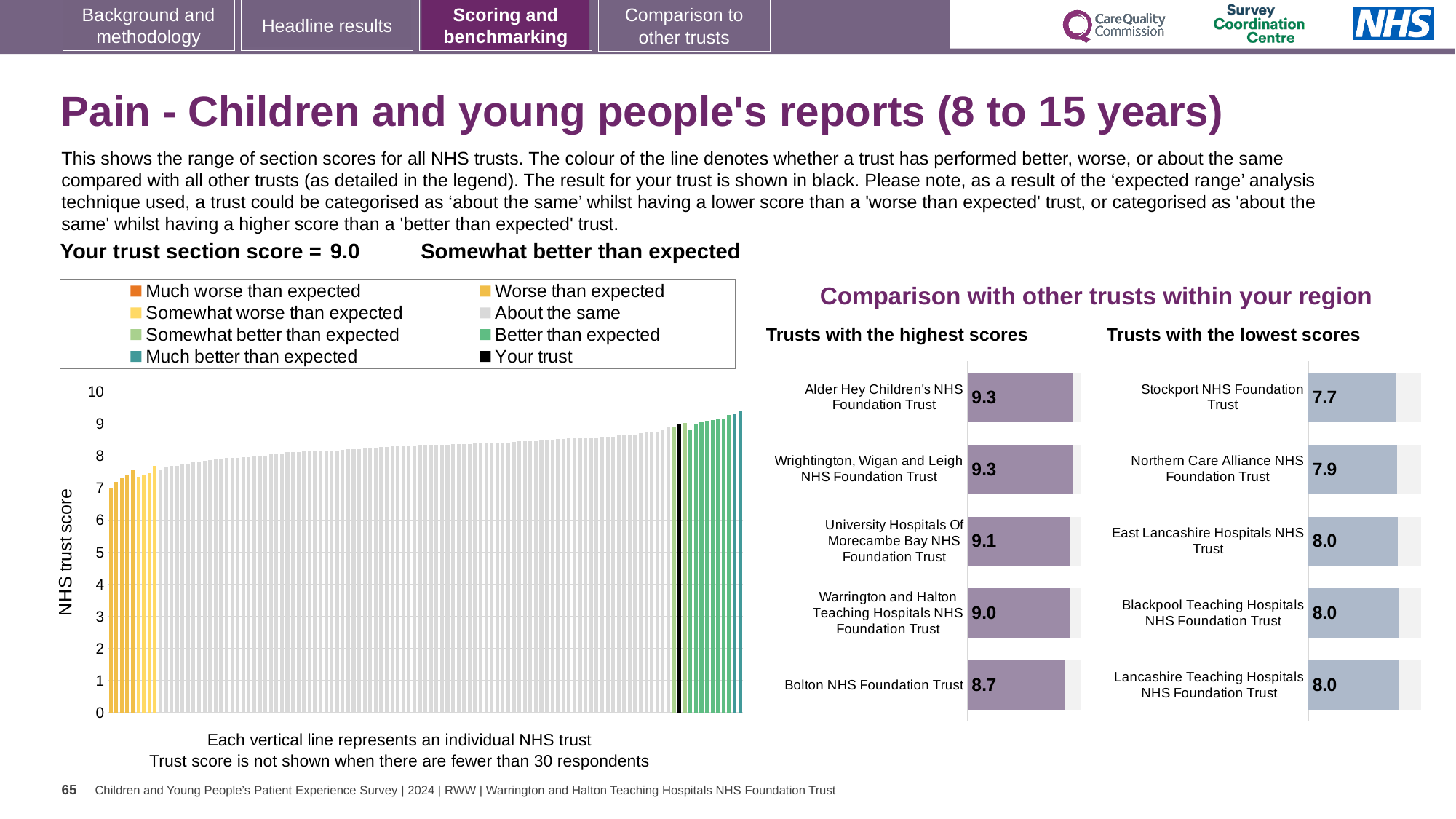
In the 'Trusts with the highest scores' chart, which has the higher score: University Hospitals Of Morecambe Bay NHS Foundation Trust or Bolton NHS Foundation Trust? University Hospitals Of Morecambe Bay NHS Foundation Trust In the 'NHS trust score' chart on the left, do the bar heights rise or fall from left to right? Rise In the 'Trusts with the highest scores' chart, which trust has the lowest score? Bolton NHS Foundation Trust What kind of chart is the 'NHS trust score' chart on the left of the slide? Bar chart In the 'Trusts with the lowest scores' chart, what is the score for Stockport NHS Foundation Trust? 7.7 In the 'Trusts with the lowest scores' chart, which trust has the lowest score? Stockport NHS Foundation Trust In the 'Trusts with the highest scores' chart, what is the difference between the scores of Alder Hey Children's NHS Foundation Trust and Bolton NHS Foundation Trust? 0.6 In the 'Trusts with the highest scores' chart, what is the score for Bolton NHS Foundation Trust? 8.7 How many entries does the legend of the 'NHS trust score' chart on the left list? 8 In the 'Trusts with the lowest scores' chart, what is the difference between the scores of Northern Care Alliance NHS Foundation Trust and Stockport NHS Foundation Trust? 0.2 How many trusts are listed in the 'Trusts with the lowest scores' chart? 5 In the 'Trusts with the highest scores' chart, what is the score for Alder Hey Children's NHS Foundation Trust? 9.3